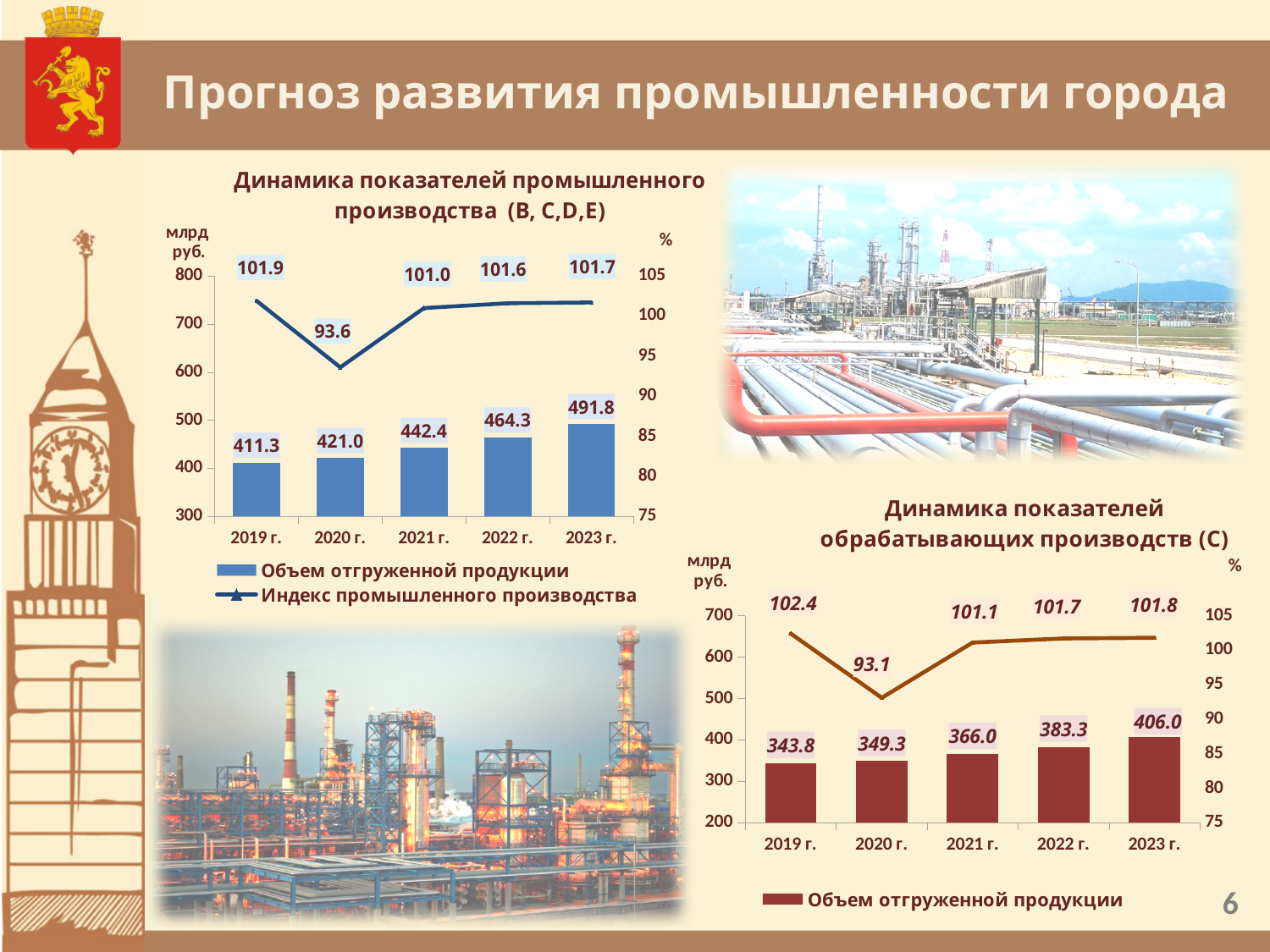
In the chart 'Динамика показателей обрабатывающих производств (C)', which is larger: the 'Объем отгруженной продукции' for 2021 г. or for 2020 г.? 2021 г. In the chart 'Динамика показателей промышленного производства (B, C,D,E)', what is the value of 'Объем отгруженной продукции' for 2021 г.? 442.4 How many series does the legend of the chart 'Динамика показателей промышленного производства (B, C,D,E)' list? 2 In the chart 'Динамика показателей обрабатывающих производств (C)', what is the index value shown on the line for 2019 г.? 102.4 In the chart 'Динамика показателей обрабатывающих производств (C)', how many years are shown on the x axis? 5 In the chart 'Динамика показателей промышленного производства (B, C,D,E)', what is the value of 'Индекс промышленного производства' for 2020 г.? 93.6 In the chart 'Динамика показателей промышленного производства (B, C,D,E)', which year has the lowest 'Индекс промышленного производства'? 2020 г. In the chart 'Динамика показателей промышленного производства (B, C,D,E)', which year has the highest 'Объем отгруженной продукции'? 2023 г. In the chart 'Динамика показателей промышленного производства (B, C,D,E)', what is the difference in 'Объем отгруженной продукции' between 2023 г. and 2019 г.? 80.5 In the chart 'Динамика показателей обрабатывающих производств (C)', which year has the lowest 'Объем отгруженной продукции'? 2019 г. In the chart 'Динамика показателей обрабатывающих производств (C)', do the bar values for 'Объем отгруженной продукции' rise or fall from 2019 г. to 2023 г.? rise In the chart 'Динамика показателей обрабатывающих производств (C)', what is the value of 'Объем отгруженной продукции' for 2022 г.? 383.3